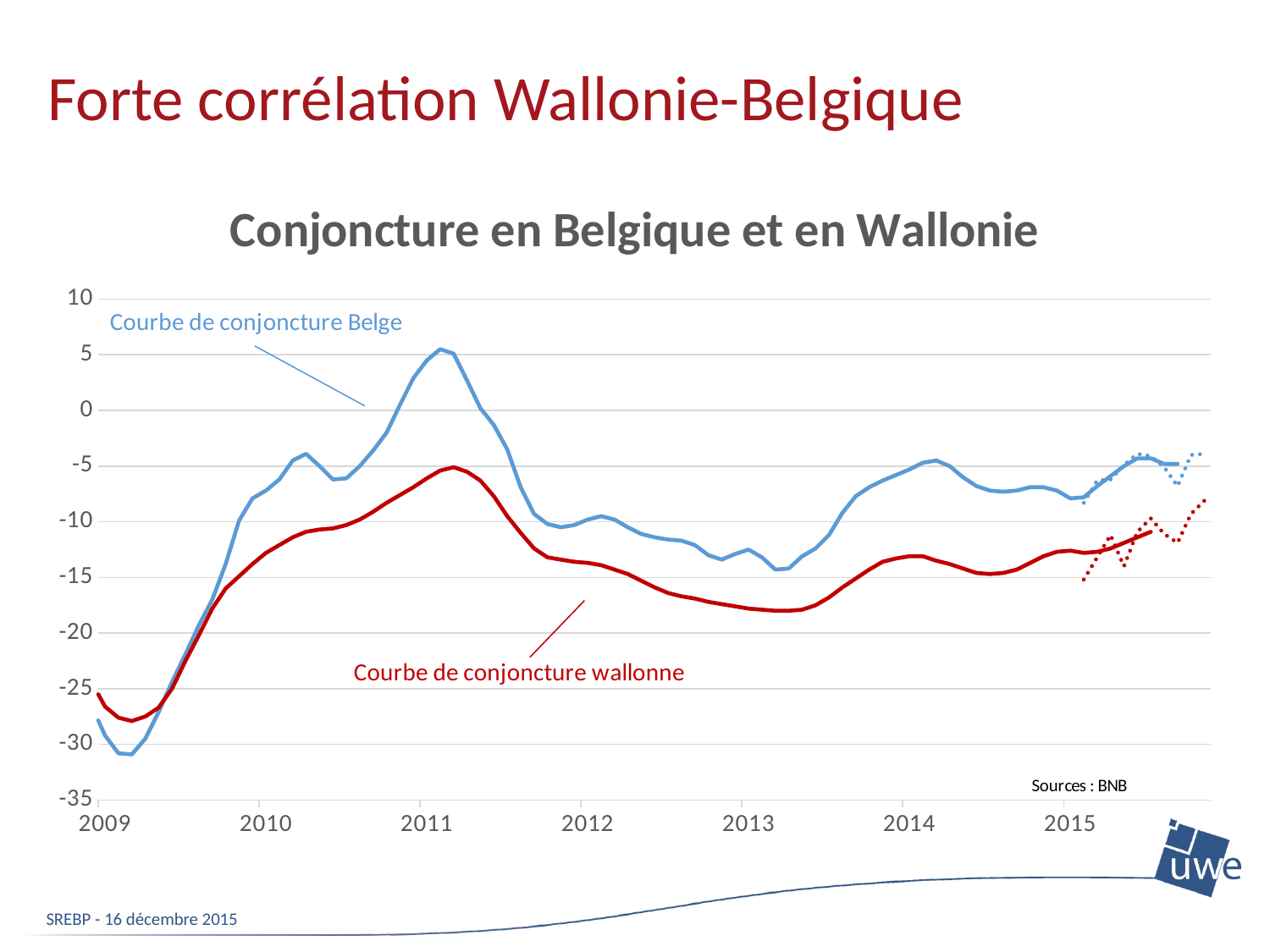
Is the value of the Courbe de conjoncture wallonne at the start of 2013 greater or less than -15? less What kind of chart is shown on the slide? line chart What is the title of the chart? Conjoncture en Belgique et en Wallonie In which year does the Courbe de conjoncture Belge reach its lowest point? 2009 In which year does the Courbe de conjoncture Belge reach its highest point? 2011 How many series are plotted on the chart? 4 Which series is drawn in red? Courbe de conjoncture wallonne Does the Courbe de conjoncture Belge rise or fall between 2009 and 2011? rise Is the value of the Courbe de conjoncture Belge at the start of 2010 greater or less than -10? greater Is the lowest value of the Courbe de conjoncture Belge greater or less than -30? less Which curve is higher at the start of 2013, the Belgian or the Walloon one? Courbe de conjoncture Belge How many year labels are shown on the x axis? 7